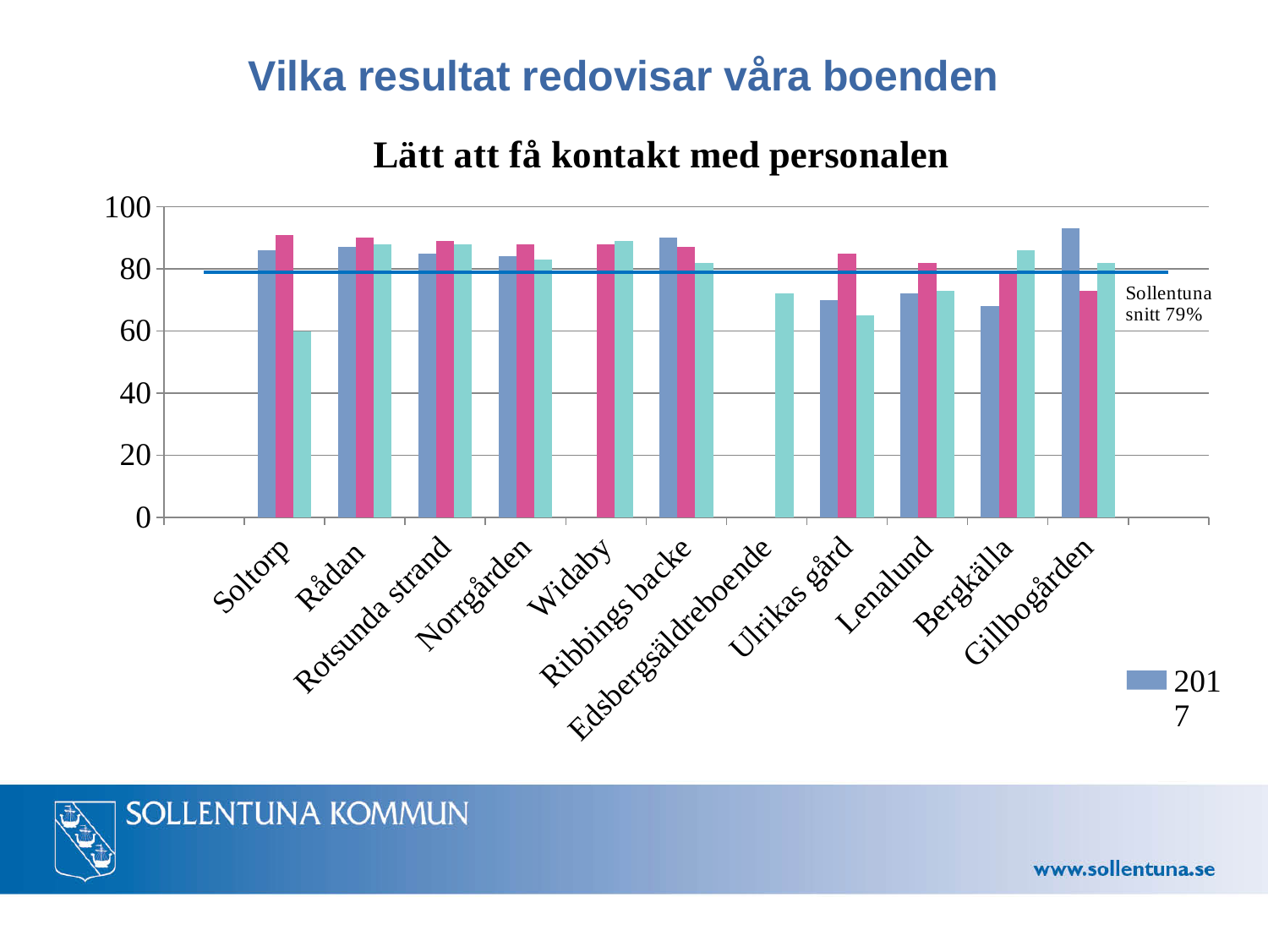
Is the value of the light teal bar for Soltorp greater or less than 80? less Is the value of the blue bar for Bergkälla greater or less than 80? less Which category has the lowest light teal bar? Soltorp How many bars are plotted for Edsbergsäldreboende? 1 For Soltorp, which is larger: the blue bar or the light teal bar? the blue bar How many categories (boenden) are shown on the x axis of the chart? 11 What type of chart is shown on the slide? bar chart Is the value of the pink bar for Rådan greater or less than 80? greater What is the title of the chart? Lätt att få kontakt med personalen What value does the horizontal reference line labelled 'Sollentuna snitt' represent? 79%